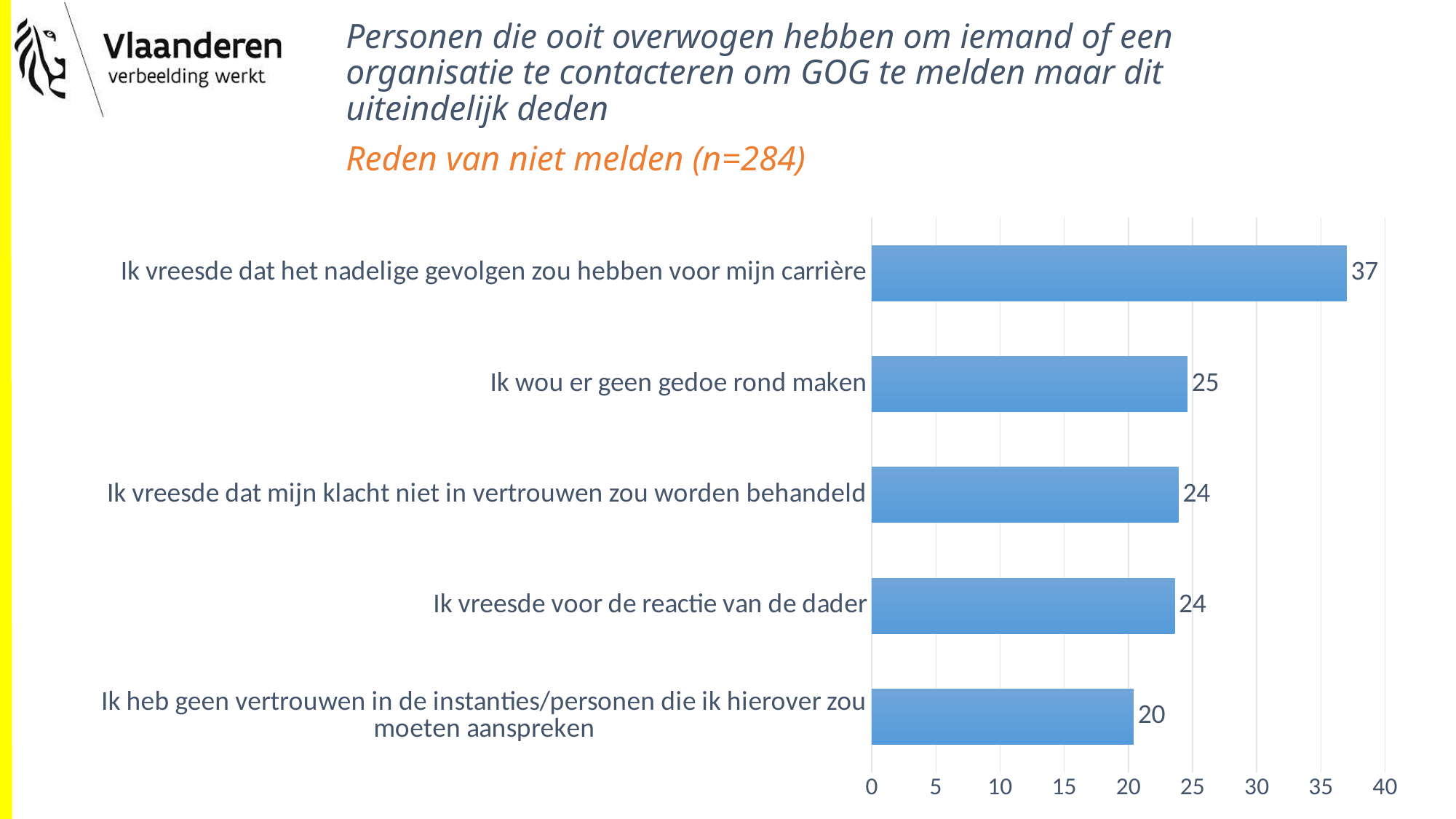
What is the difference between the value for 'Ik vreesde voor de reactie van de dader' and the value for 'Ik heb geen vertrouwen in de instanties/personen die ik hierover zou moeten aanspreken'? 4 How many reasons are shown in the chart? 5 What kind of chart is shown on the slide? Bar chart What is the difference between the value for 'Ik vreesde dat het nadelige gevolgen zou hebben voor mijn carrière' and the value for 'Ik wou er geen gedoe rond maken'? 12 What is the orange subtitle of the chart? Reden van niet melden (n=284) Which reason has the lowest value? Ik heb geen vertrouwen in de instanties/personen die ik hierover zou moeten aanspreken Which reason has the highest value? Ik vreesde dat het nadelige gevolgen zou hebben voor mijn carrière What is the value for 'Ik wou er geen gedoe rond maken'? 25 What is the value for 'Ik vreesde voor de reactie van de dader'? 24 Which is larger: the value for 'Ik vreesde dat het nadelige gevolgen zou hebben voor mijn carrière' or the value for 'Ik vreesde dat mijn klacht niet in vertrouwen zou worden behandeld'? Ik vreesde dat het nadelige gevolgen zou hebben voor mijn carrière What is the value for 'Ik heb geen vertrouwen in de instanties/personen die ik hierover zou moeten aanspreken'? 20 What is the value for 'Ik vreesde dat het nadelige gevolgen zou hebben voor mijn carrière'? 37